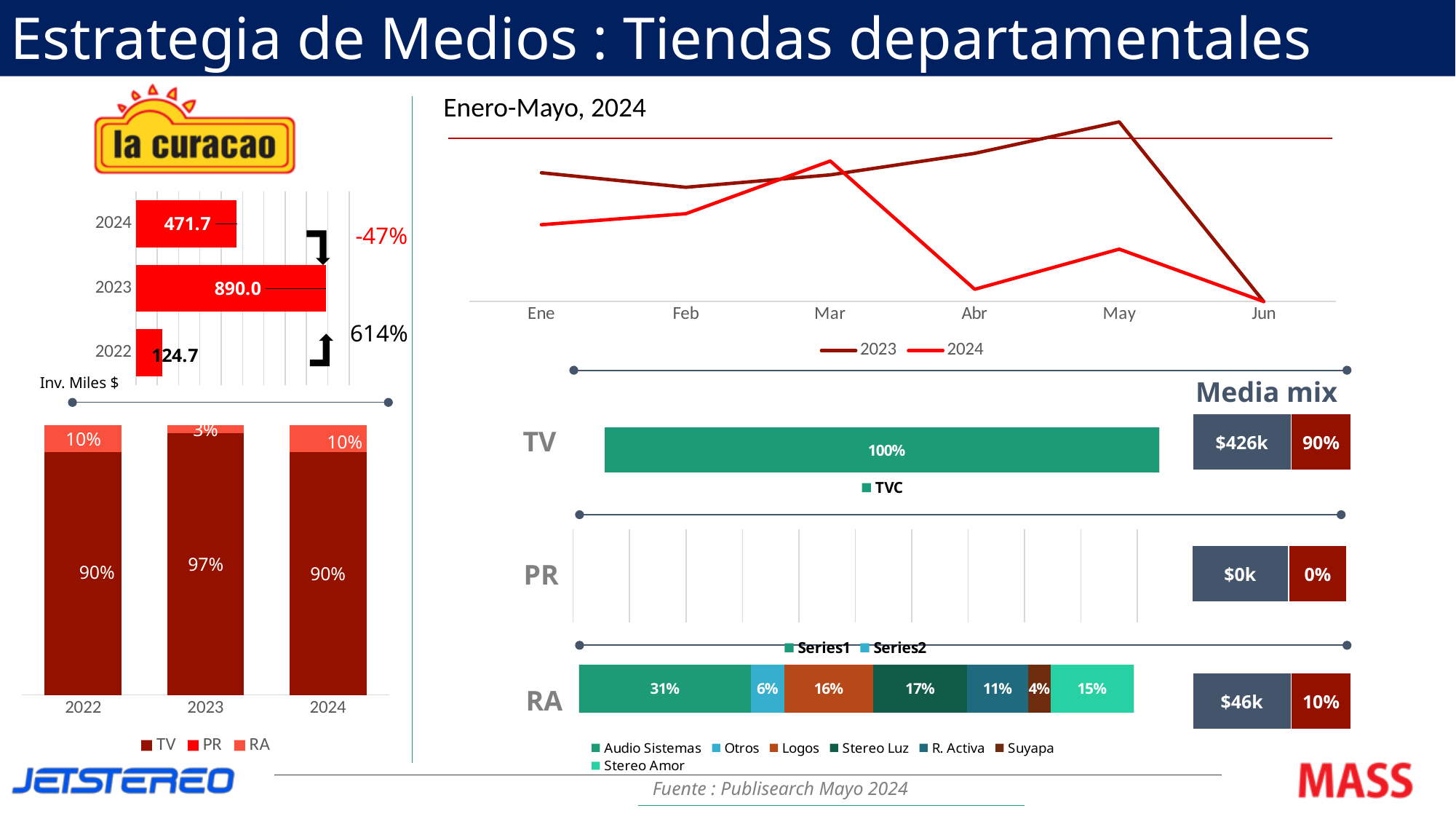
In the stacked bar chart at the bottom left, how many series does the legend list? 3 In the Media mix boxes, what is the amount shown for TV? $426k In the investment bar chart on the left (Inv. Miles $), which year has the highest value? 2023 In the RA stacked bar, what is the share for Audio Sistemas? 31% In the investment bar chart on the left (Inv. Miles $), what is the value for 2023? 890.0 In the stacked bar chart at the bottom left, what is the TV share for 2023? 97% What kind of chart is the Enero-Mayo, 2024 chart? Line chart In the RA stacked bar, which station has the smallest share? Suyapa In the investment bar chart on the left (Inv. Miles $), which year has the lowest value? 2022 In the investment bar chart on the left (Inv. Miles $), what is the difference between the 2023 and 2024 values? 418.3 In the Enero-Mayo, 2024 line chart, how many months are shown on the x axis? 6 In the Enero-Mayo, 2024 chart, which series is higher in Abr, 2023 or 2024? 2023